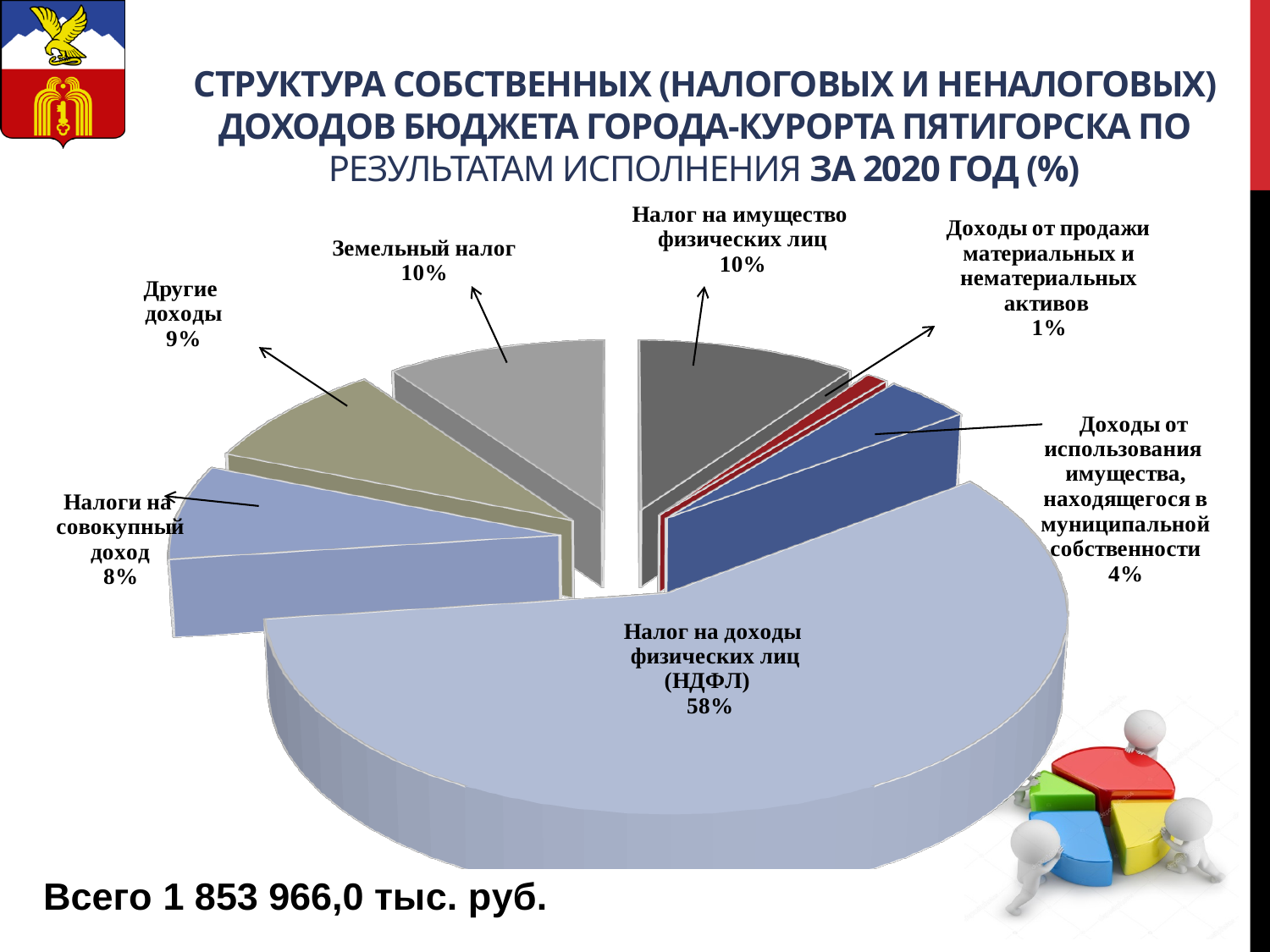
What is the difference in percentage points between "Налог на доходы физических лиц (НДФЛ)" and "Земельный налог"? 48% What total amount is stated at the bottom of the slide? 1 853 966,0 тыс. руб. What is the difference in percentage points between "Другие доходы" and "Налоги на совокупный доход"? 1% Which is larger: "Другие доходы" or "Доходы от использования имущества, находящегося в муниципальной собственности"? Другие доходы How many categories (slices) does the pie chart have? 7 What share of the pie does "Налог на доходы физических лиц (НДФЛ)" account for? 58% Which category has the largest share of the pie? Налог на доходы физических лиц (НДФЛ) What kind of chart is shown on the slide? Pie chart What is the value shown for "Земельный налог"? 10% Which category has the smallest share of the pie? Доходы от продажи материальных и нематериальных активов What is the value shown for "Налоги на совокупный доход"? 8% What is the value shown for "Доходы от использования имущества, находящегося в муниципальной собственности"? 4%